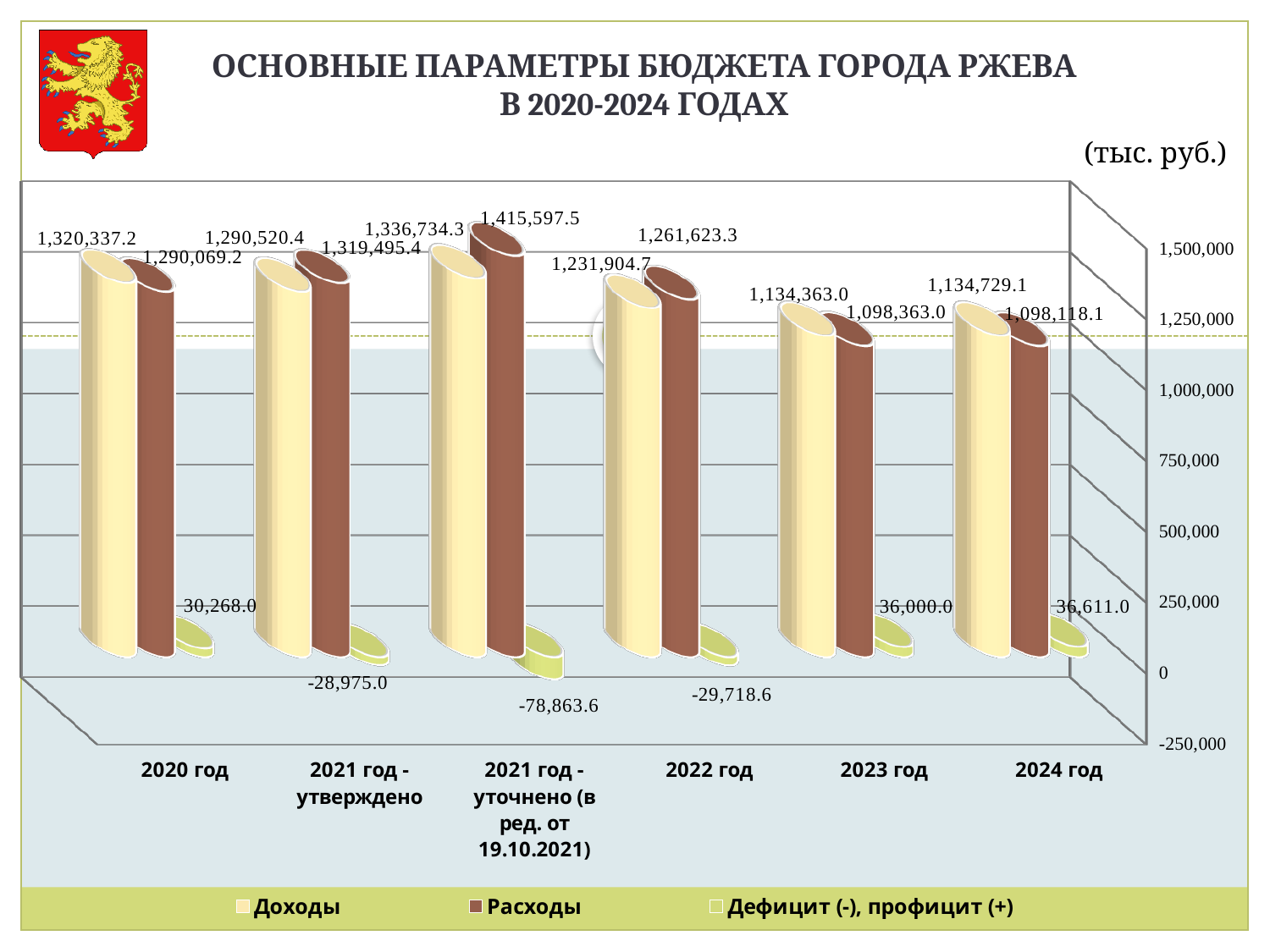
How many series does the legend list? 3 What unit is stated for the values on the chart? тыс. руб. What is the value of Доходы for 2020 год? 1,320,337.2 Which is larger for 2022 год: Доходы or Расходы? Расходы Which category has the lowest value of Дефицит (-), профицит (+)? 2021 год - уточнено (в ред. от 19.10.2021) What kind of chart is shown on the slide? Bar chart What is the value of Расходы for 2024 год? 1,098,118.1 Which category has the highest value of Расходы? 2021 год - уточнено (в ред. от 19.10.2021) What is the value of Расходы for 2021 год - уточнено (в ред. от 19.10.2021)? 1,415,597.5 How many categories are shown on the x axis? 6 What is the difference between Доходы and Расходы for 2020 год? 30,268.0 What is the value of Дефицит (-), профицит (+) for 2022 год? -29,718.6